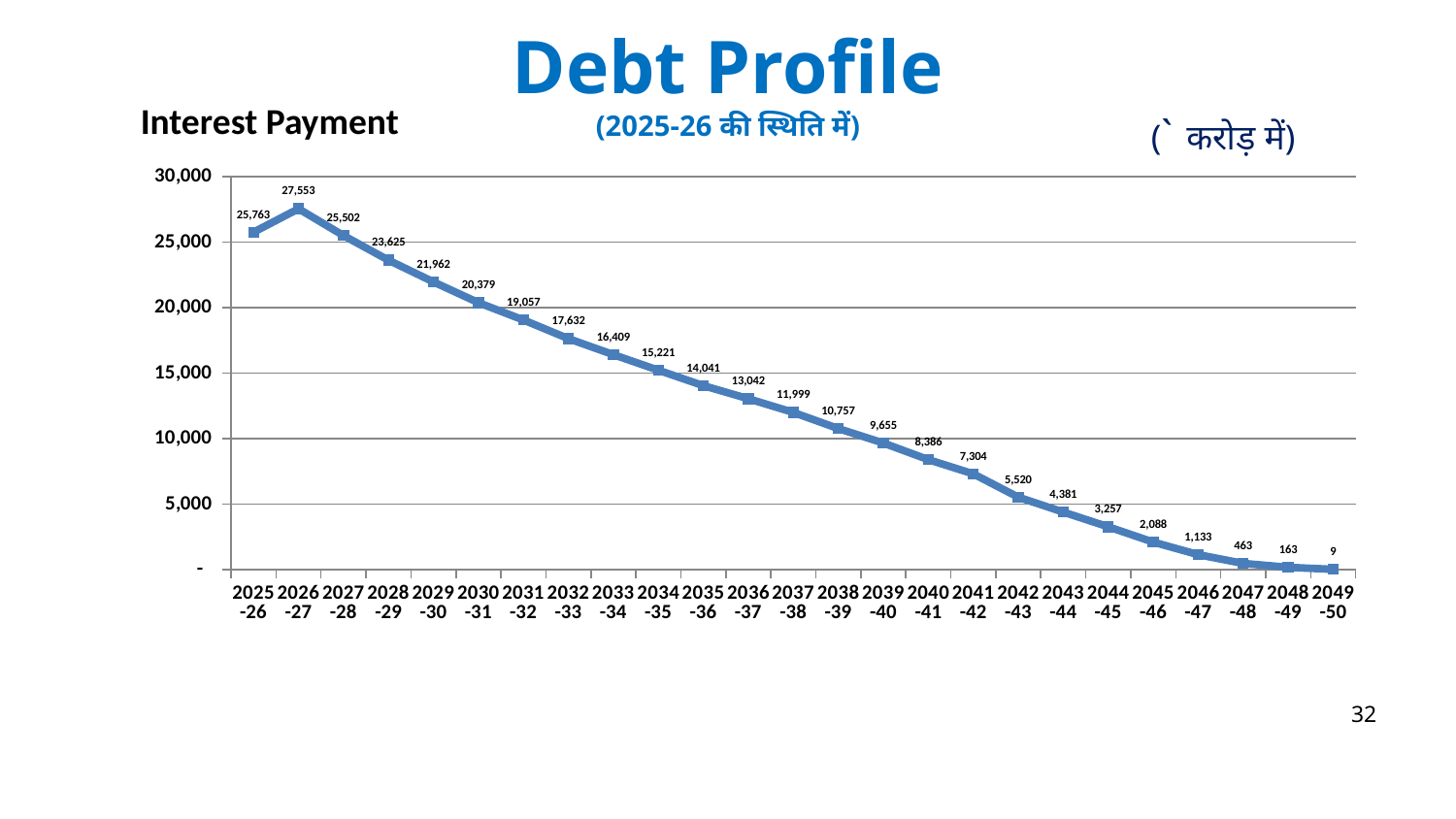
What kind of chart is shown on the slide? line chart What is the interest payment value for 2035-36? 14,041 How many years are plotted on the chart? 25 Is the interest payment for 2038-39 greater or less than 10,000? greater Which year has the lowest interest payment? 2049-50 What is the difference between the interest payment in 2030-31 and 2040-41? 11,993 Which is larger, the interest payment in 2027-28 or in 2028-29? 2027-28 Which year has the highest interest payment? 2026-27 What is the difference between the interest payment in 2026-27 and 2025-26? 1,790 What is the interest payment value for 2026-27? 27,553 After 2026-27, do the interest payment values rise or fall over the years? fall What is the interest payment value for 2049-50? 9